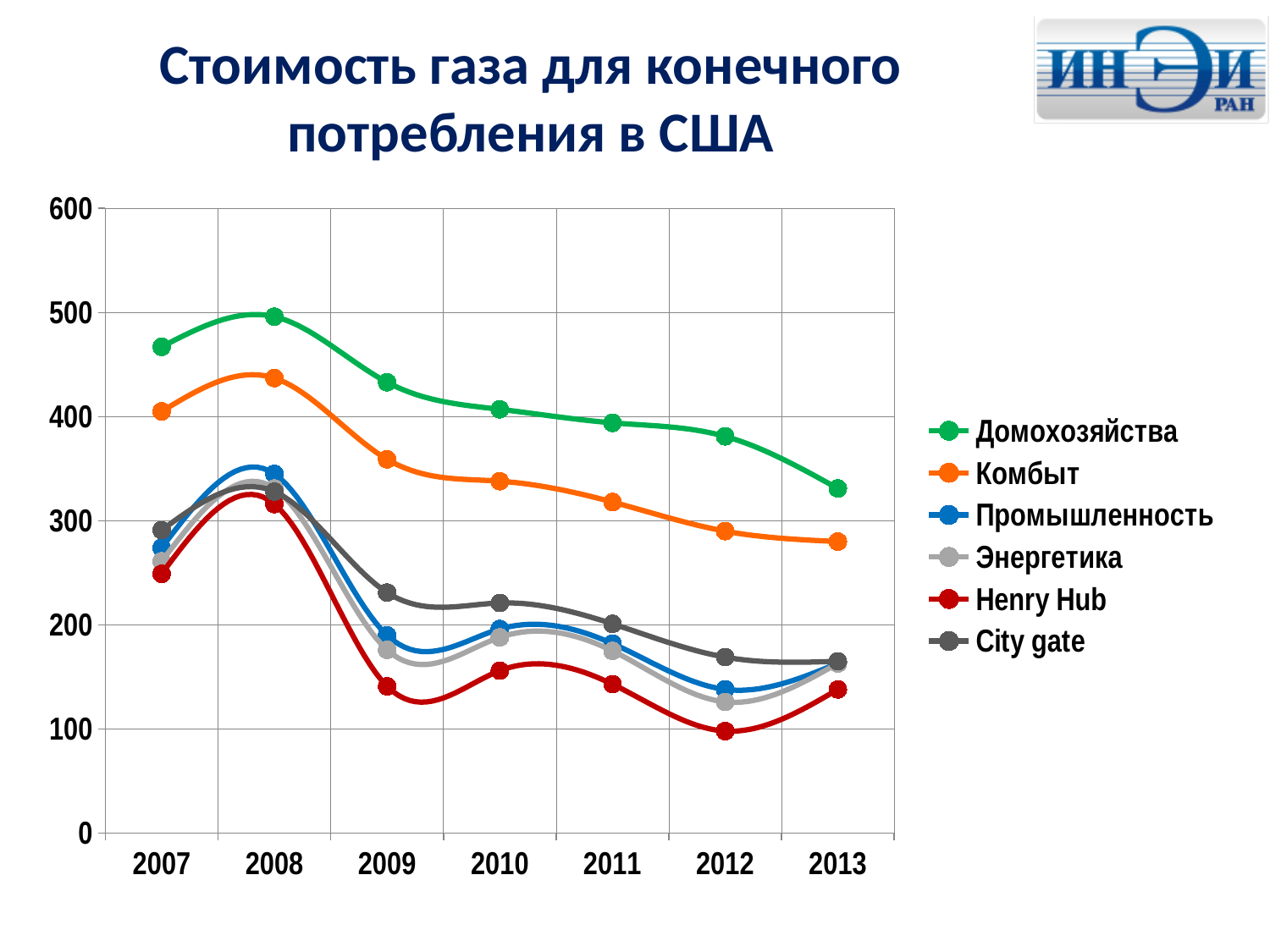
Does the Домохозяйства series rise or fall from 2008 to 2013? fall How many series does the legend list? 6 What kind of chart is shown on the slide? line chart Is the value for Домохозяйства in 2007 greater or less than 400? greater In which year does the Henry Hub series reach its lowest value? 2012 Is the value for Комбыт in 2013 greater or less than 300? less In which year does the Домохозяйства series reach its highest value? 2008 Which series has the higher value in 2013, Домохозяйства or Комбыт? Домохозяйства Which series has the highest value in 2012? Домохозяйства How many years are shown on the x axis? 7 What is the title of the chart? Стоимость газа для конечного потребления в США Is the value for City gate in 2009 greater or less than 200? greater